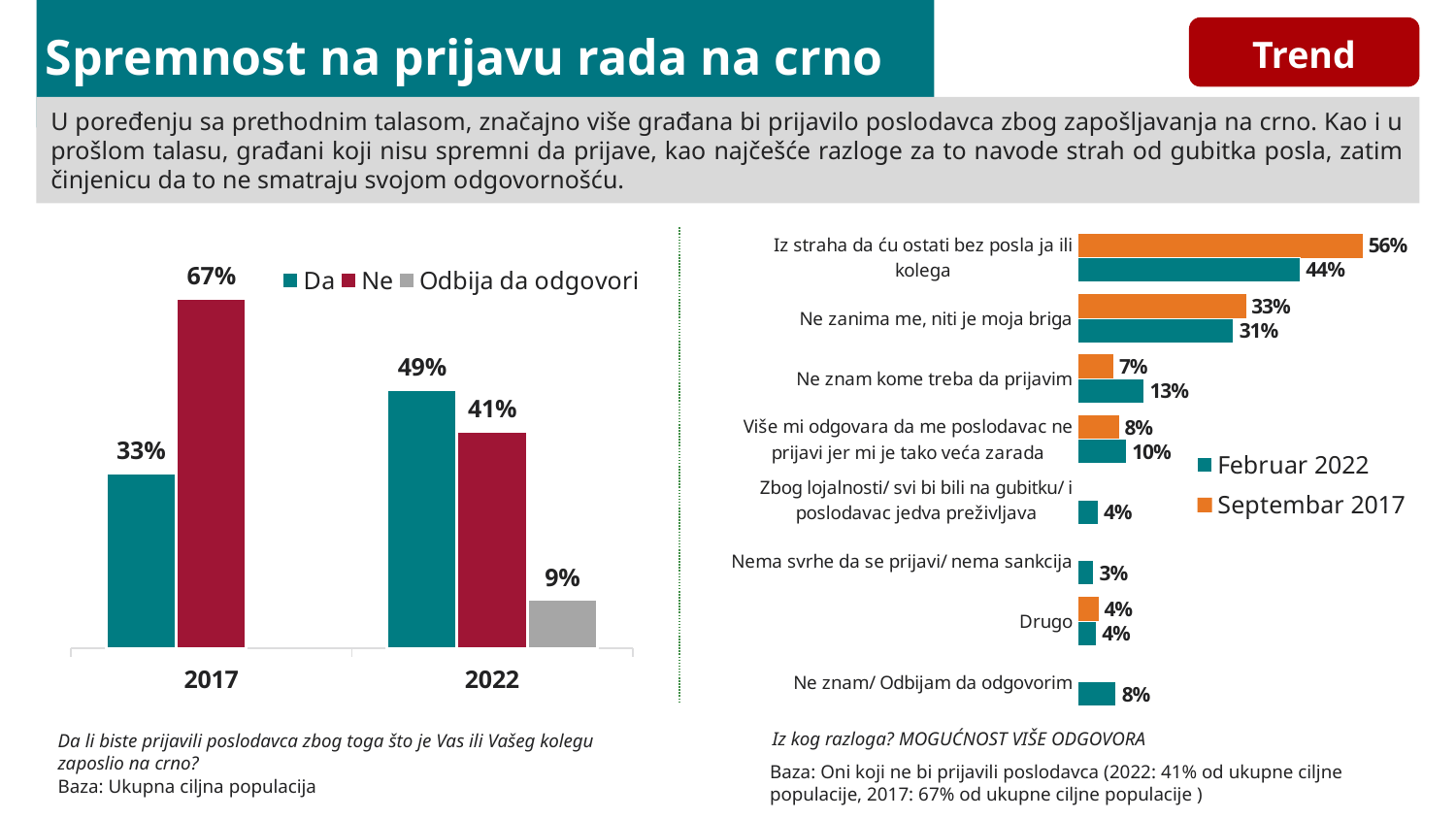
In the right chart, what is the Februar 2022 value for "Ne znam kome treba da prijavim"? 13% In the left chart, what is the value for "Da" in 2022? 49% In the left chart, what is the value for "Ne" in 2017? 67% What kind of chart is the right chart? Bar chart In the right chart, how many reason categories are shown? 8 In the left chart, what is the difference between "Da" in 2022 and "Da" in 2017? 16% In the left chart, how many series does the legend list? 3 In the right chart, which reason has the highest Februar 2022 value? Iz straha da ću ostati bez posla ja ili kolega In the left chart, which is larger in 2022, "Da" or "Ne"? Da In the right chart, what is the Septembar 2017 value for "Iz straha da ću ostati bez posla ja ili kolega"? 56% In the left chart, what is the value for "Odbija da odgovori" in 2022? 9% In the right chart, what is the difference between the Septembar 2017 and Februar 2022 values for "Iz straha da ću ostati bez posla ja ili kolega"? 12%